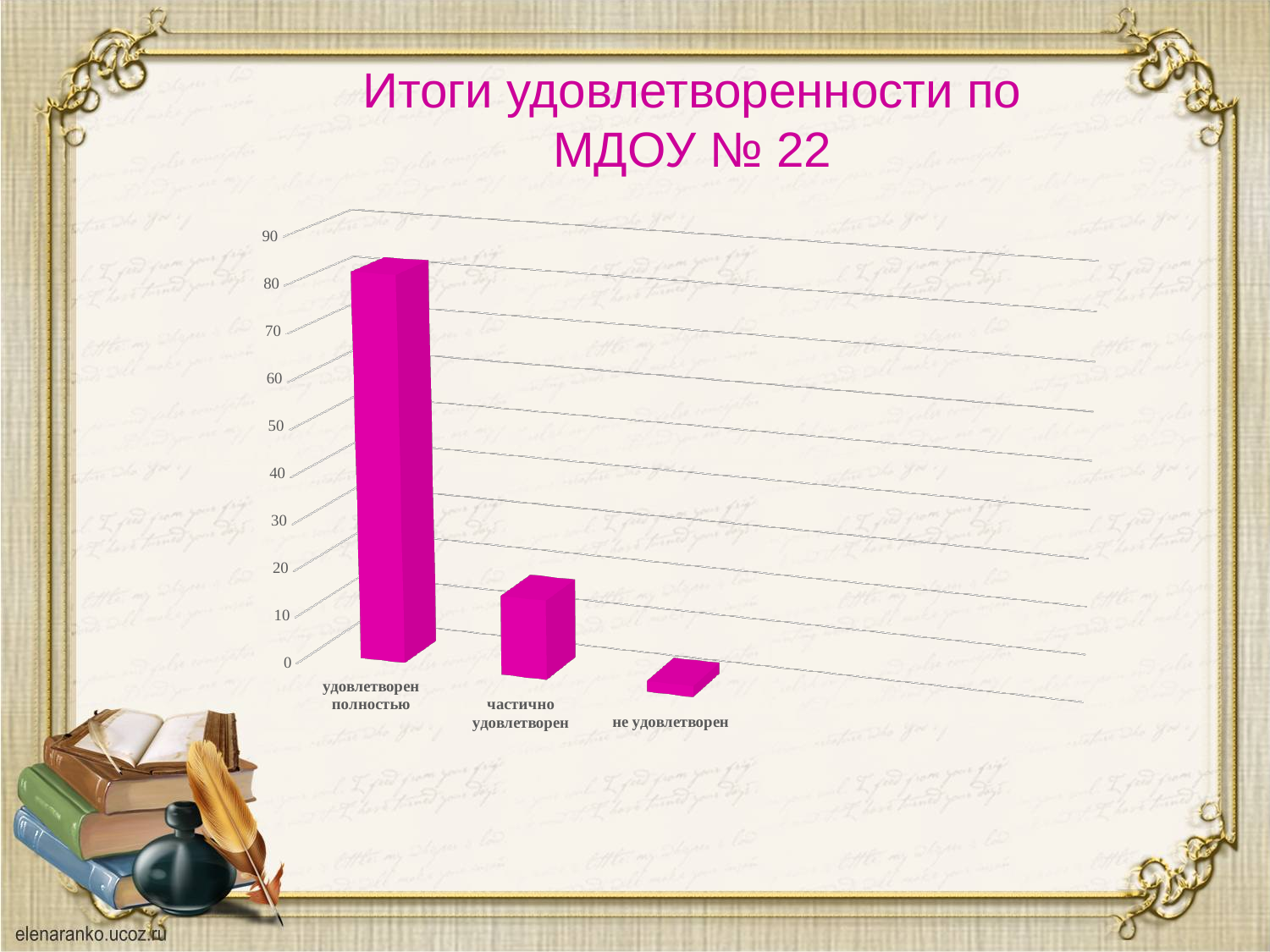
What is the title of the chart on the slide? Итоги удовлетворенности по МДОУ № 22 What is the highest value shown on the vertical axis of the chart? 90 Which category has the lowest bar? не удовлетворен Is the value for 'удовлетворен полностью' greater or less than 70? greater What kind of chart is shown on the slide? bar chart Which is larger, the value for 'частично удовлетворен' or the value for 'не удовлетворен'? частично удовлетворен Which category has the highest bar? удовлетворен полностью How many categories are shown on the x axis of the chart? 3 Which is larger, the value for 'удовлетворен полностью' or the value for 'частично удовлетворен'? удовлетворен полностью Is the value for 'частично удовлетворен' greater or less than 30? less Is the value for 'не удовлетворен' greater or less than 10? less Do the bar values rise or fall from left to right along the x axis? fall